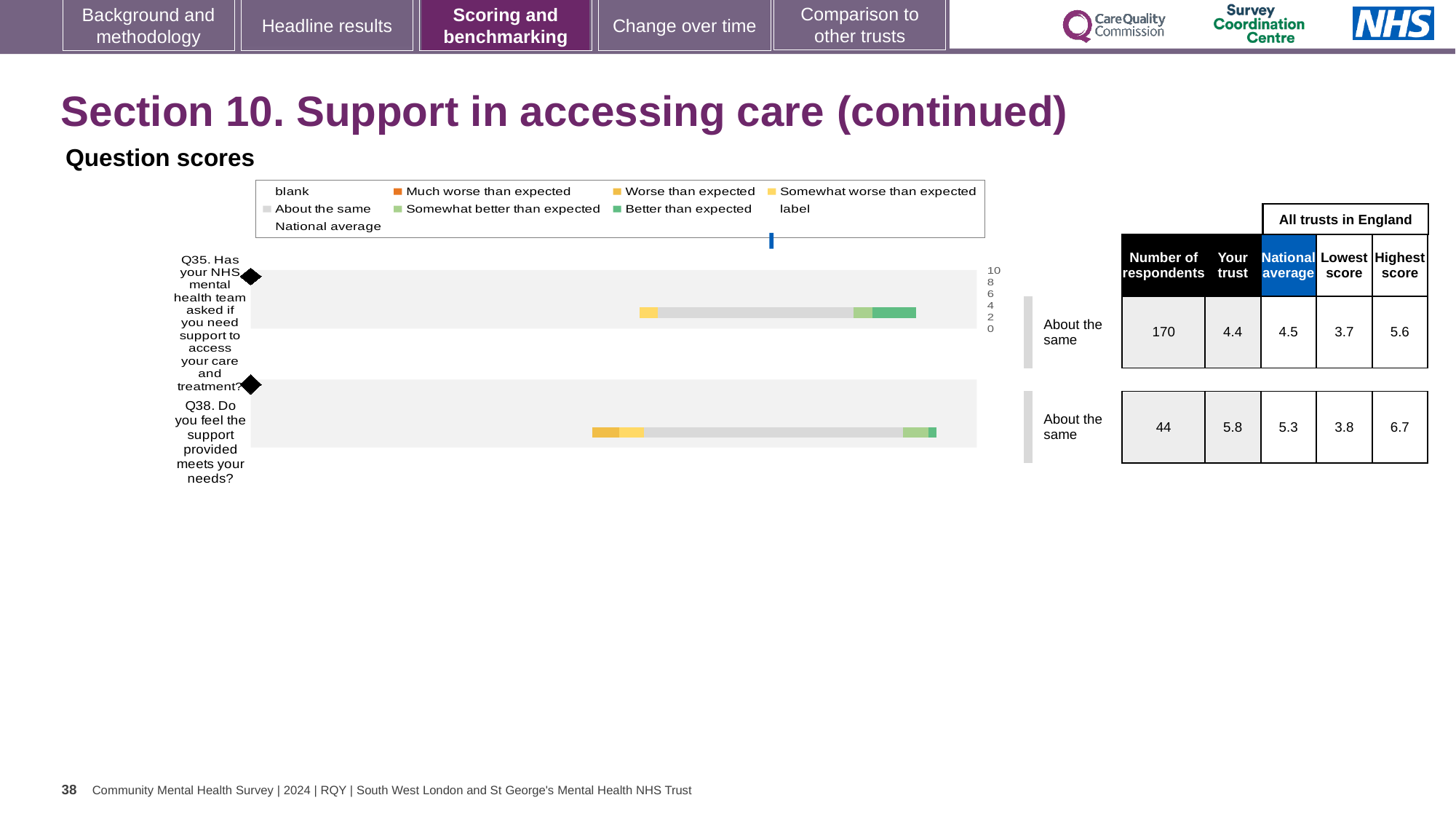
Which question has the higher 'Your trust' score, Q35 or Q38? Q38 What is the difference between the 'Your trust' score and the national average for Q38? 0.5 How many questions are plotted in the question scores chart? 2 What kind of chart is used to show the question scores on this slide? bar chart What is the number of respondents for Q35? 170 What benchmark rating is shown for Q35? About the same What is the 'Your trust' score for Q38? 5.8 What is the national average score for Q35? 4.5 What is the highest score among all trusts in England for Q38? 6.7 What is the lowest score among all trusts in England for Q35? 3.7 Which question has more respondents, Q35 or Q38? Q35